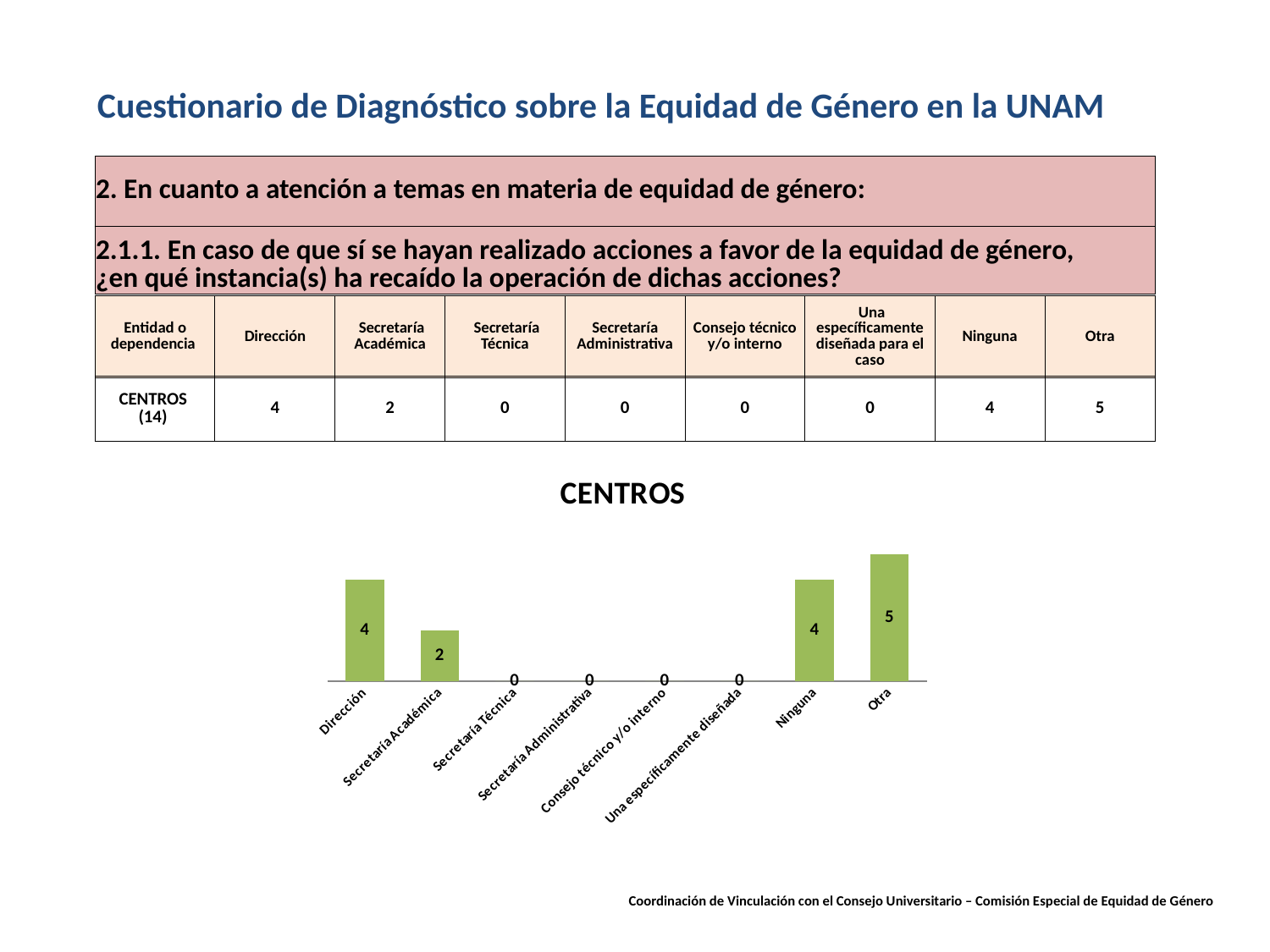
How many categories in the CENTROS chart have a value of 0? 4 What kind of chart is the CENTROS chart? Bar chart What is the value for Dirección in the CENTROS chart? 4 Which category has the highest value in the CENTROS chart? Otra What is the value for Secretaría Académica in the CENTROS chart? 2 What colour are the bars in the CENTROS chart? Green What is the difference between the values for Otra and Secretaría Académica in the CENTROS chart? 3 What is the value for Otra in the CENTROS chart? 5 How many categories are shown on the x axis of the CENTROS chart? 8 What is the value for Secretaría Técnica in the CENTROS chart? 0 Which is larger in the CENTROS chart, Dirección or Secretaría Académica? Dirección What is the title of the chart on the slide? CENTROS